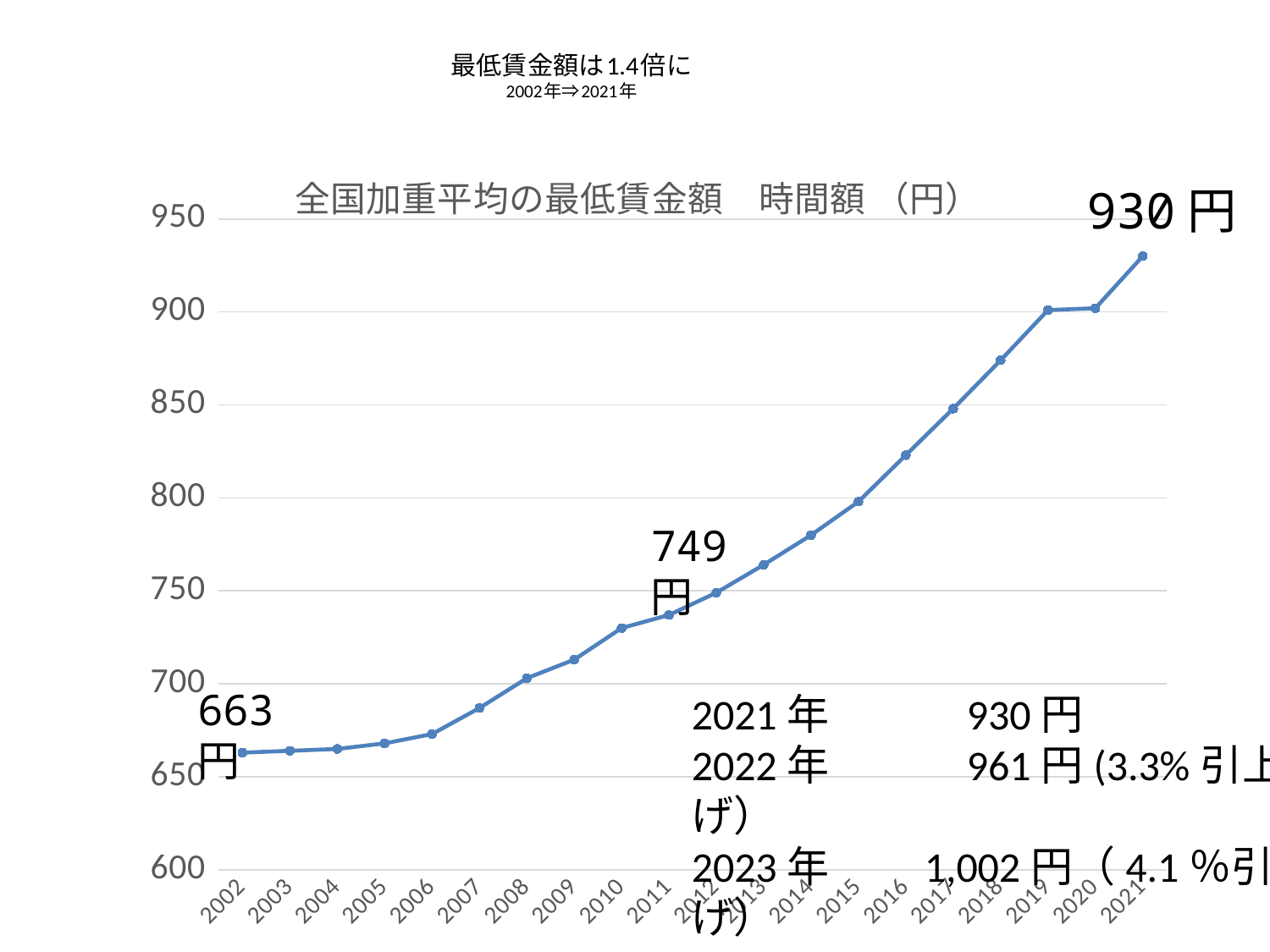
Do the values rise or fall from 2002 to 2021? rise Which year has the lowest value on the chart? 2002 Is the value for 2018 greater or less than 900? less What is the difference between the labelled values for 2021 and 2002? 267円 What kind of chart is shown on the slide? line chart How many years are plotted on the x axis? 20 Is the value for 2007 greater or less than 700? less What is the title of the chart? 全国加重平均の最低賃金額 時間額（円） Which year has the highest value on the chart? 2021 What is the minimum wage value labelled for 2002? 663円 What is the minimum wage value labelled for 2021? 930円 Is the value for 2016 greater or less than 800? greater